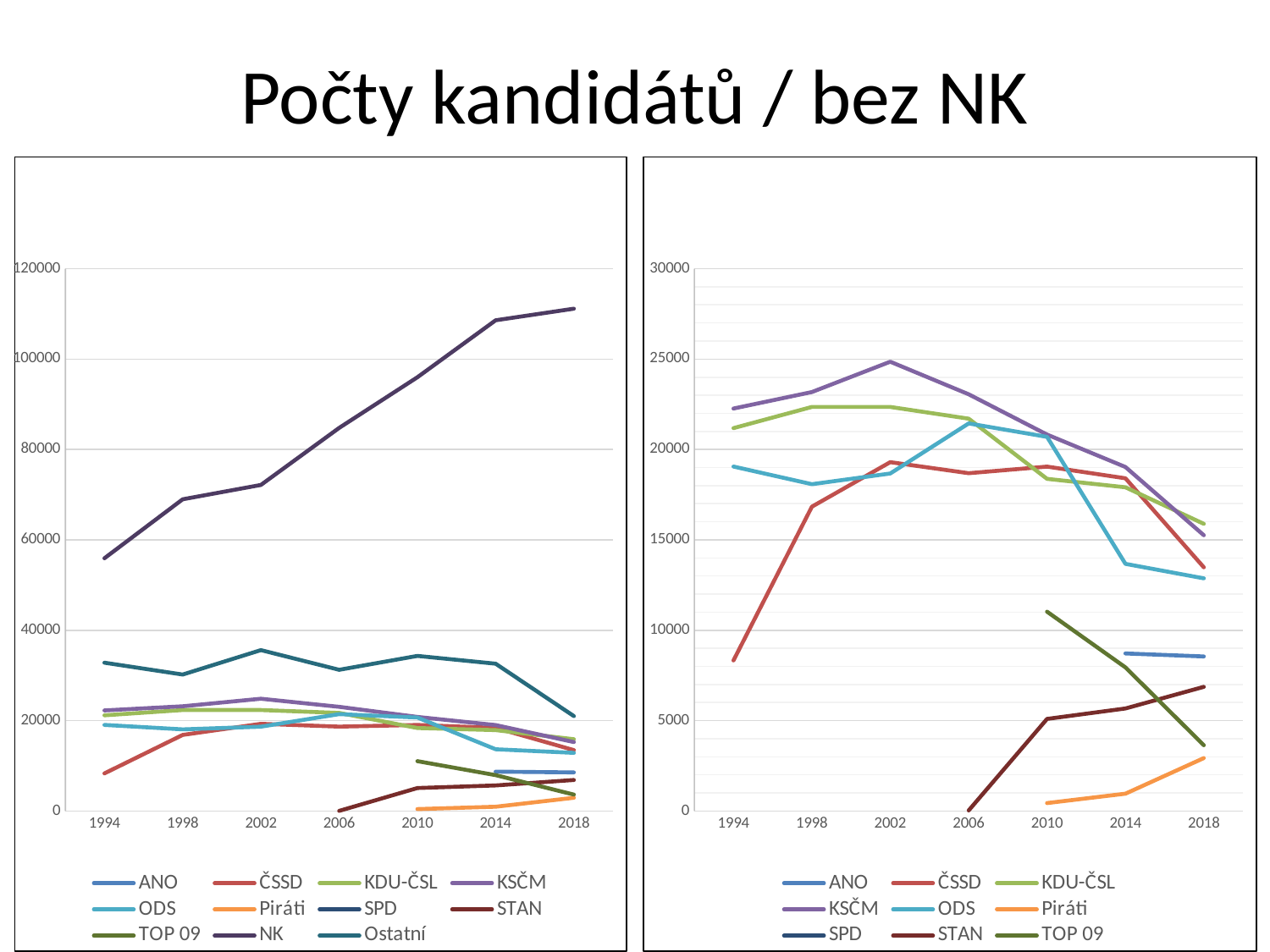
In the right chart, which series has the lowest value in 2018? Piráti In the right chart, is the value for ČSSD in 1994 greater or less than 10000? less In the right chart, which series has the highest value in 2002? KSČM How many years are shown on the x axis of the right chart? 7 In the left chart, which series has the highest values across all years? NK In the left chart, does the NK series rise or fall from 1994 to 2018? rise In the right chart, which is larger in 2006, ODS or ČSSD? ODS How many series does the legend of the left chart list? 11 How many series does the legend of the right chart list? 9 In the left chart, is the value for NK in 2018 greater or less than 100000? greater What kind of chart is the left chart on the slide? line chart In the left chart, is the value for NK in 1994 greater or less than 60000? less